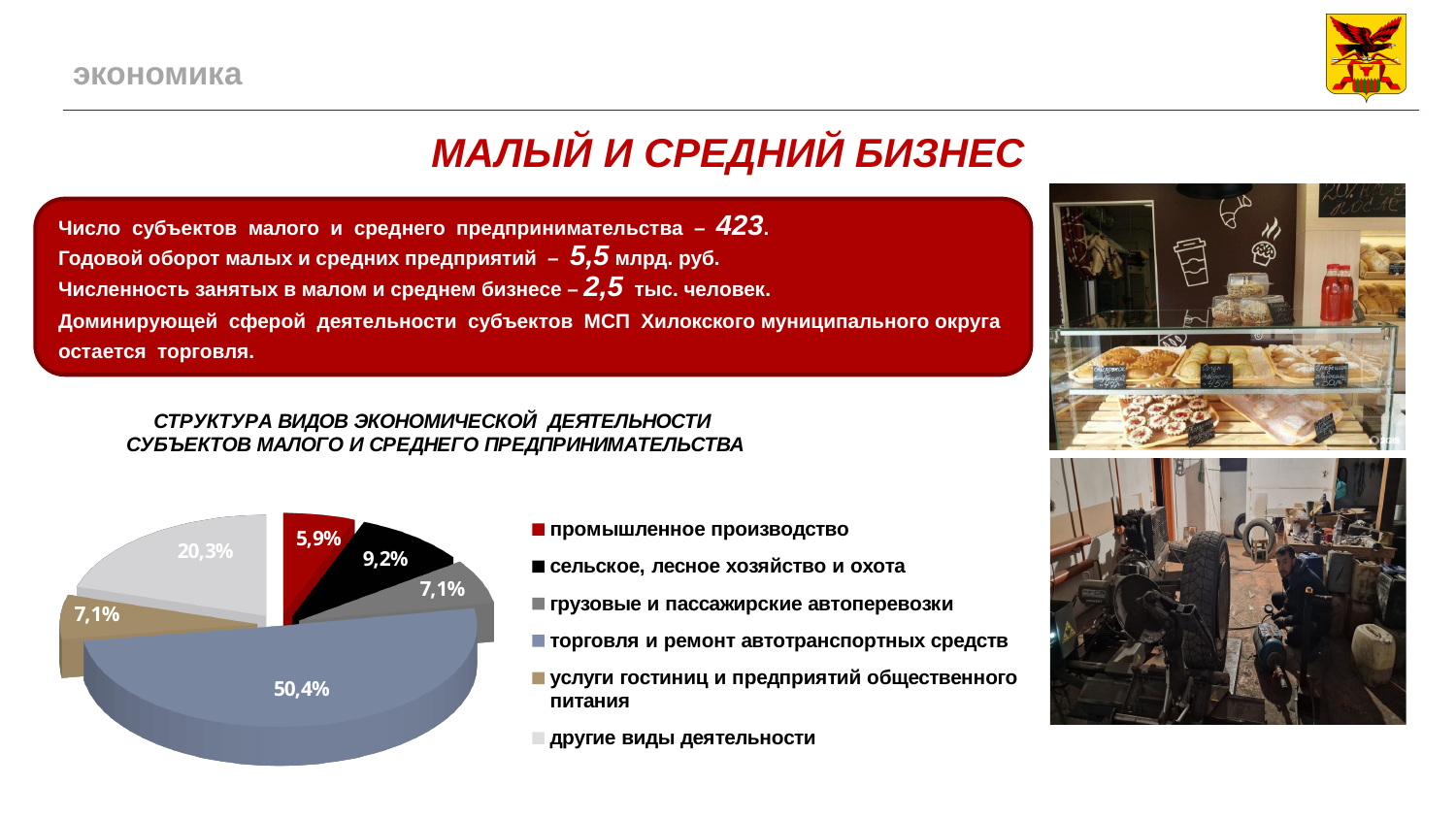
What is the difference between the shares of 'торговля и ремонт автотранспортных средств' and 'другие виды деятельности'? 30,1% What colour is the slice for 'промышленное производство' in the pie chart? red What share of the pie does 'торговля и ремонт автотранспортных средств' hold? 50,4% Which category has the smallest share in the pie chart? промышленное производство What is the value for 'промышленное производство' in the pie chart? 5,9% What is the value for 'другие виды деятельности' in the pie chart? 20,3% Which is larger: the share of 'сельское, лесное хозяйство и охота' or 'грузовые и пассажирские автоперевозки'? сельское, лесное хозяйство и охота What kind of chart is shown on the slide? pie chart How many slices does the pie chart have? 6 What is the value for 'услуги гостиниц и предприятий общественного питания' in the pie chart? 7,1% Which category has the largest share in the pie chart? торговля и ремонт автотранспортных средств What is the value for 'сельское, лесное хозяйство и охота' in the pie chart? 9,2%